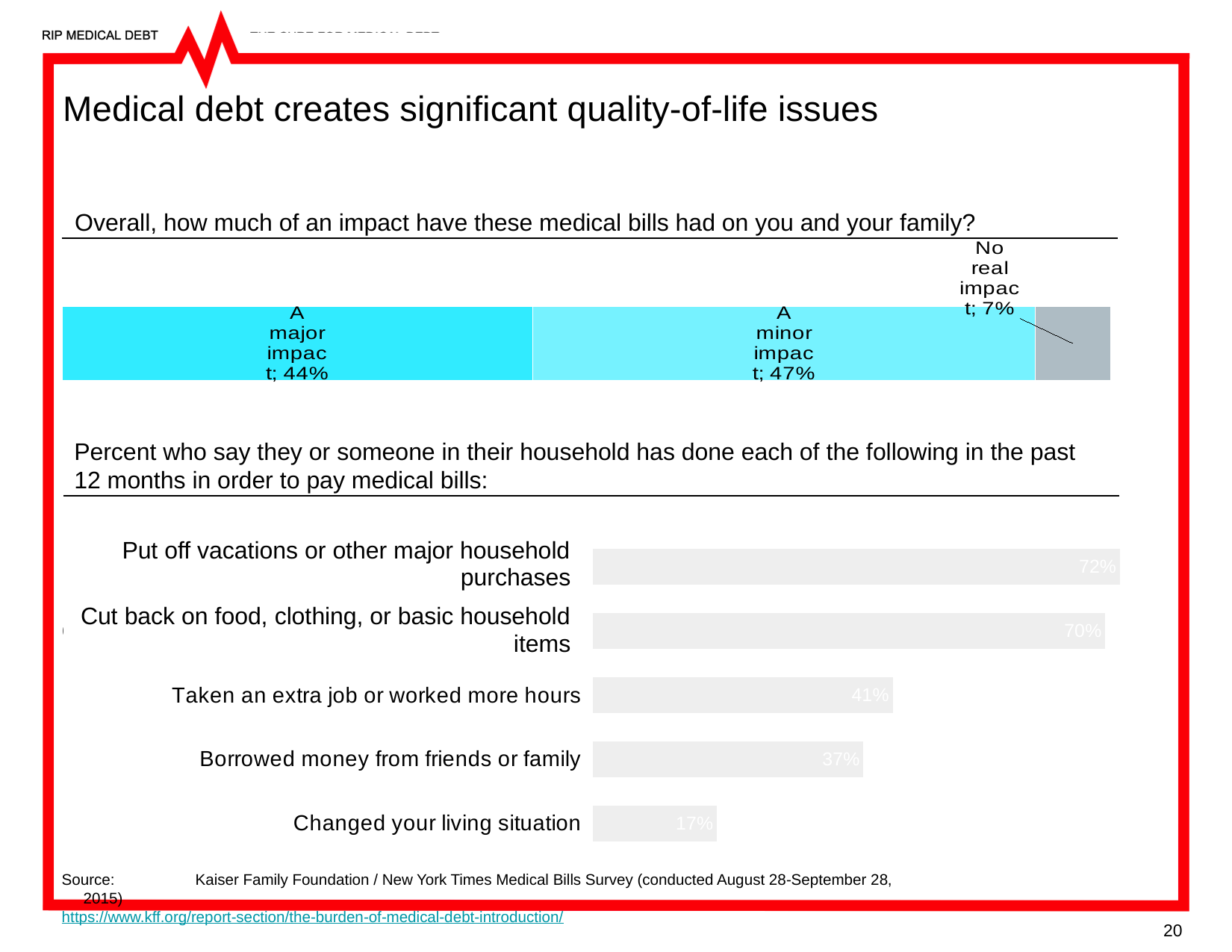
In the top chart about the impact of medical bills, what percentage said the bills had no real impact? 7% In the bottom chart of actions taken to pay medical bills, what is the difference between the percent who took an extra job or worked more hours and the percent who borrowed money from friends or family? 4% In the bottom chart of actions taken to pay medical bills, what percent put off vacations or other major household purchases? 72% In the bottom chart of actions taken to pay medical bills, which action has the lowest percentage? Changed your living situation In the top chart about the impact of medical bills, what percentage said the bills had a minor impact? 47% In the top chart about the impact of medical bills, how many response categories are shown? 3 In the top chart about the impact of medical bills, what percentage said the bills had a major impact? 44% What type of chart is the bottom chart of actions taken to pay medical bills? Bar chart In the bottom chart of actions taken to pay medical bills, which action has the highest percentage? Put off vacations or other major household purchases In the bottom chart of actions taken to pay medical bills, how many actions are listed? 5 In the bottom chart of actions taken to pay medical bills, what percent changed their living situation? 17% In the top chart about the impact of medical bills, which response has the smallest share? No real impact